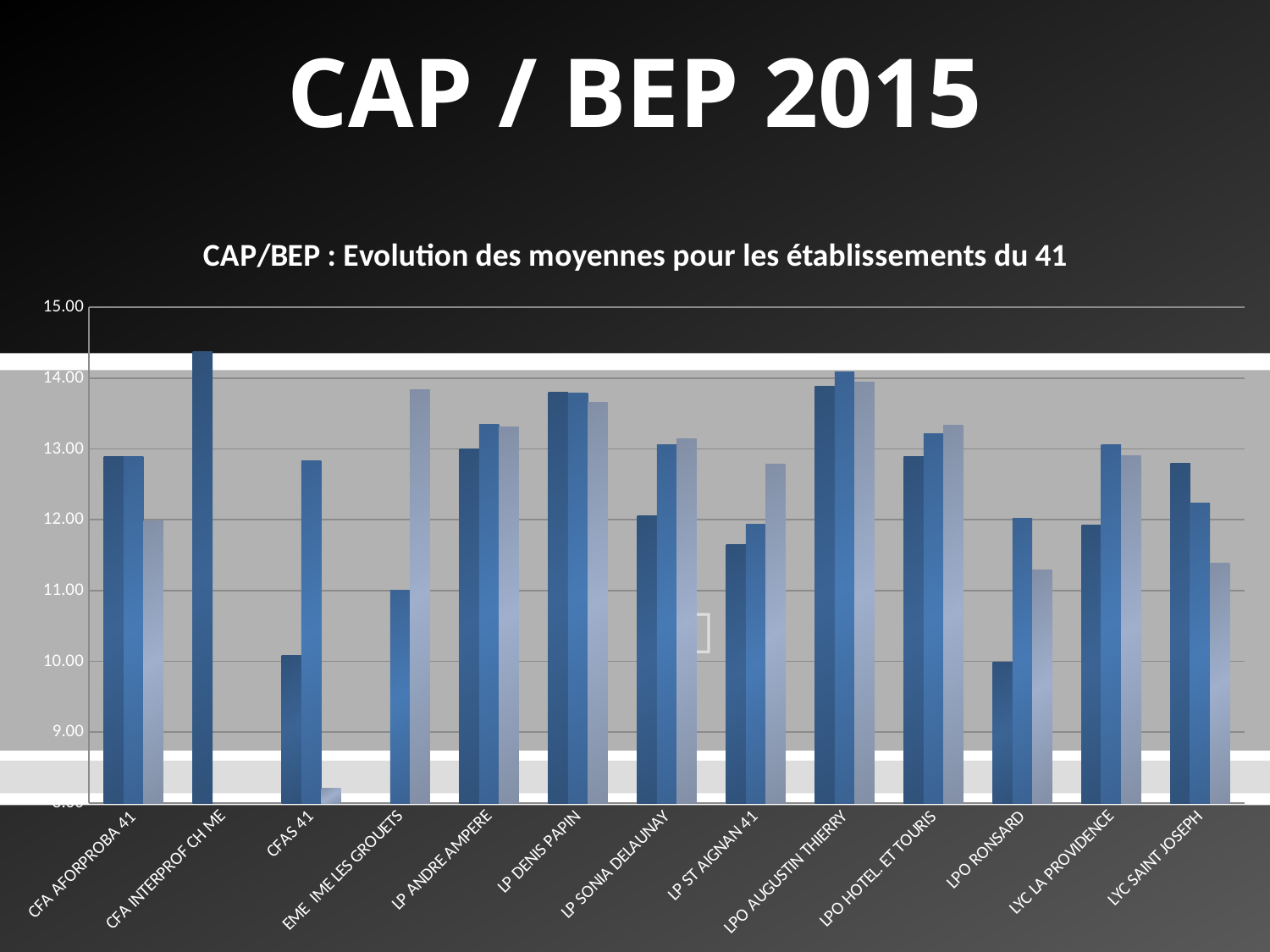
Which establishment has the shortest bar in the chart? CFAS 41 What is the highest value shown on the vertical axis of the chart? 15.00 Is the value of the bar for CFA INTERPROF CH ME greater or less than 14.00? greater What kind of chart is shown on the slide? bar chart Is the value of the first (leftmost) bar for LP ST AIGNAN 41 greater or less than 12.00? less Is the value of the third (rightmost) bar for LYC SAINT JOSEPH greater or less than 12.00? less How many establishments (categories) are shown on the x axis of the chart? 13 Which is larger: the first bar for CFA INTERPROF CH ME or the first bar for CFA AFORPROBA 41? CFA INTERPROF CH ME Which establishment has the tallest bar in the chart? CFA INTERPROF CH ME What is the title of the chart? CAP/BEP : Evolution des moyennes pour les établissements du 41